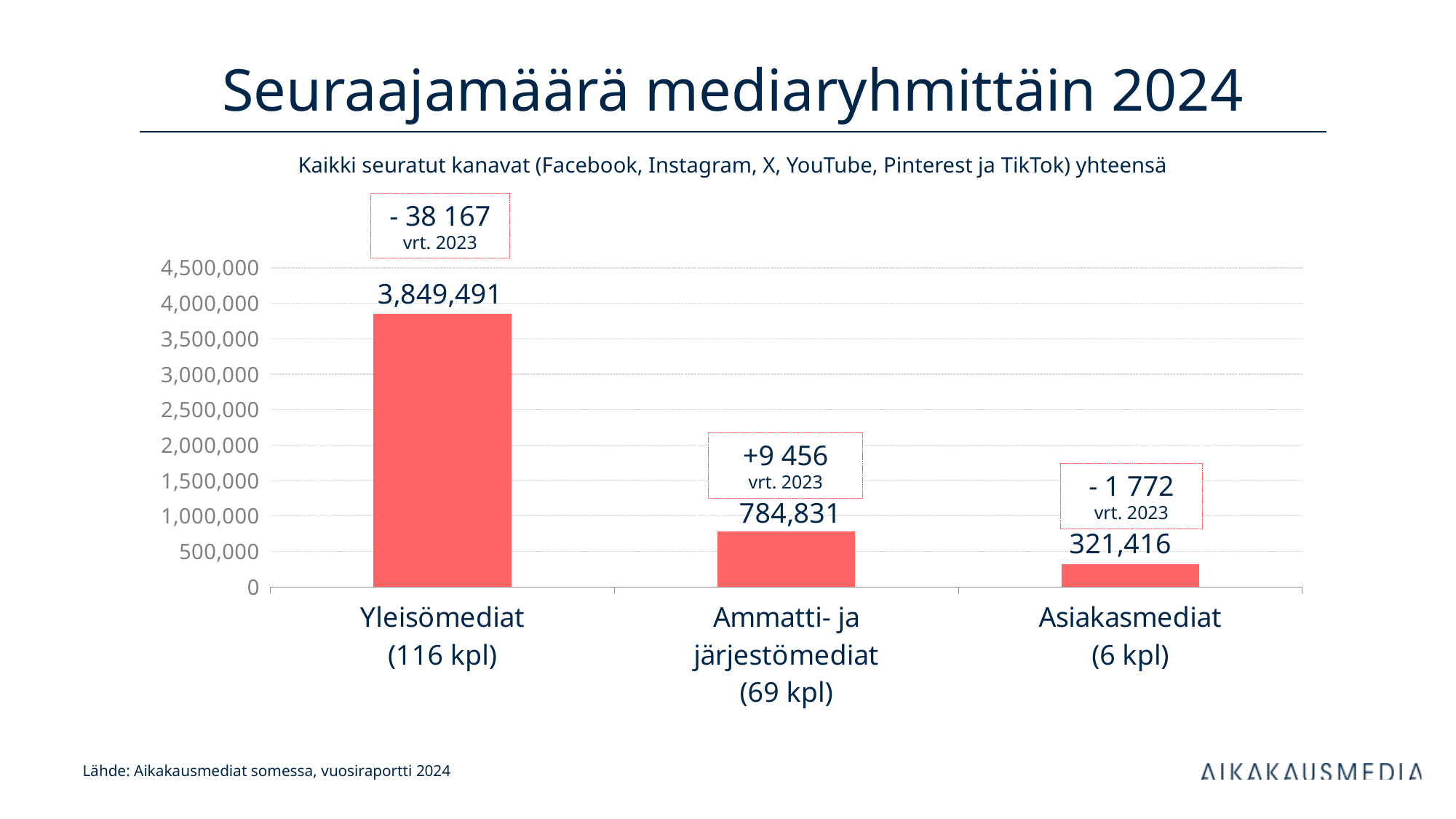
What kind of chart is shown on the slide? bar chart Which has more followers, Ammatti- ja järjestömediat or Asiakasmediat? Ammatti- ja järjestömediat What is the difference in follower count between Yleisömediat and Ammatti- ja järjestömediat? 3,064,660 Which media group has the lowest follower count? Asiakasmediat Is the follower count for Ammatti- ja järjestömediat greater or less than 1,000,000? less How many media groups are shown in the chart? 3 What change compared to 2023 is annotated for Ammatti- ja järjestömediat? +9 456 Which media group has the highest follower count? Yleisömediat What is the follower count for Asiakasmediat? 321,416 What is the difference in follower count between Ammatti- ja järjestömediat and Asiakasmediat? 463,415 What is the follower count for Yleisömediat? 3,849,491 What is the follower count for Ammatti- ja järjestömediat? 784,831